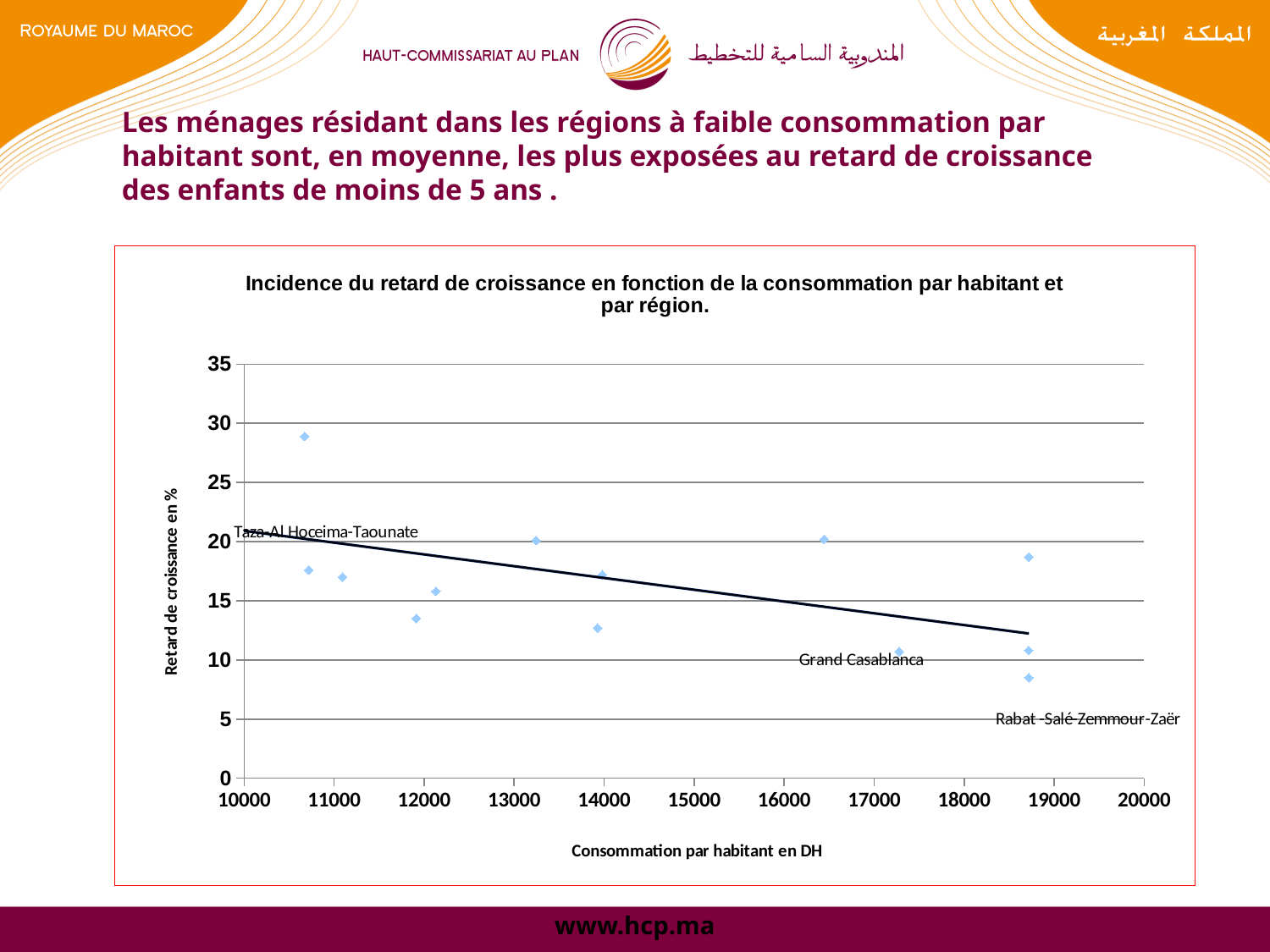
Which has the higher retard de croissance: the point labelled Grand Casablanca or the highest point near 10700 DH? the highest point near 10700 DH What is the label of the vertical axis? Retard de croissance en % What is the maximum value shown on the vertical axis? 35 Is the lowest plotted value of retard de croissance greater or less than 10? less Is the consumption per inhabitant of the point with the highest retard de croissance greater or less than 12000 DH? less What kind of chart is shown on the slide? scatter chart What is the title of the chart? Incidence du retard de croissance en fonction de la consommation par habitant et par région. Is the highest plotted value of retard de croissance greater or less than 25? greater Does the trend line rise or fall as consumption per inhabitant increases? fall